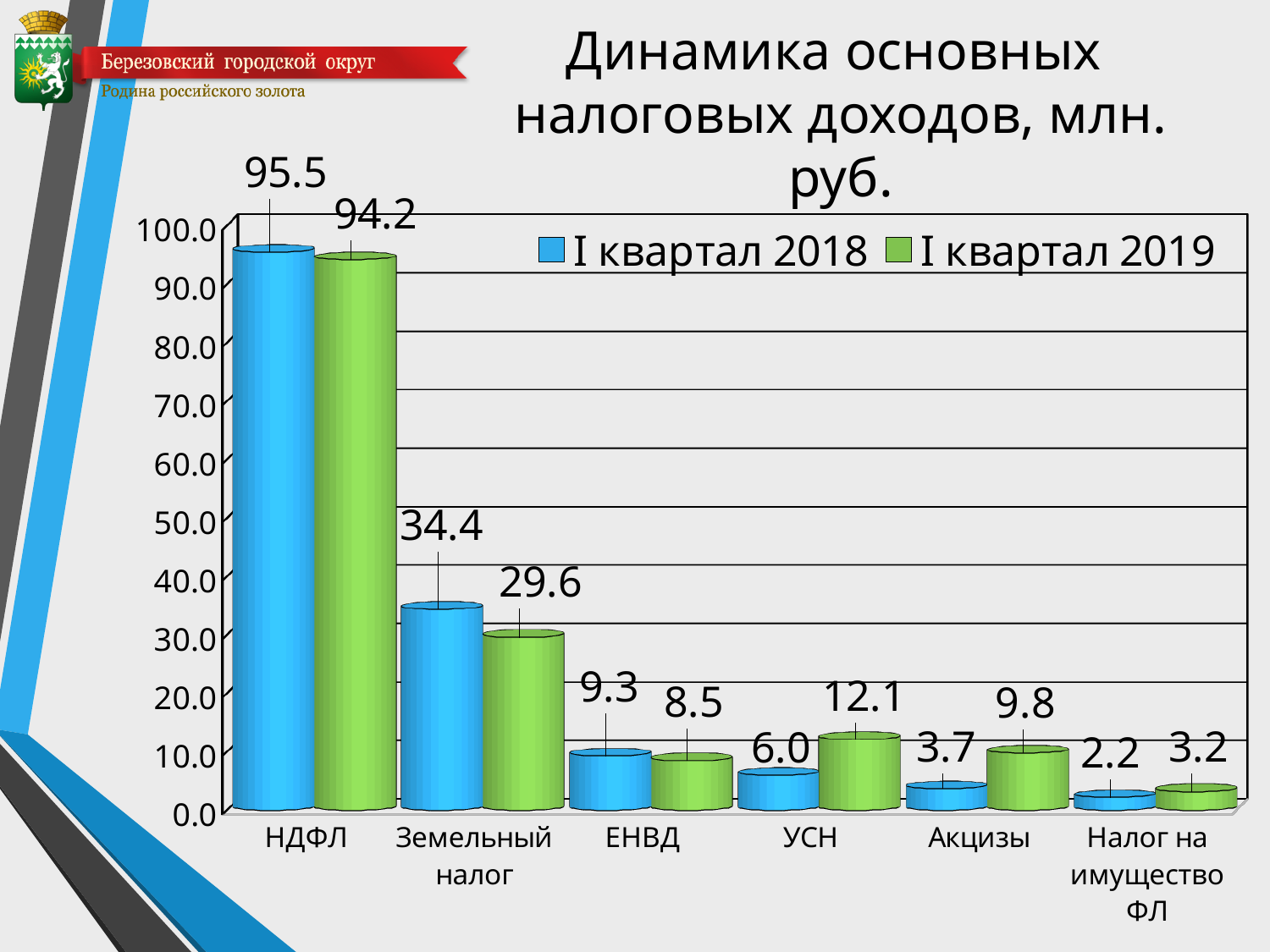
What is the value for НДФЛ in the I квартал 2018 series? 95.5 What kind of chart is shown on the slide? Bar chart Which category has the lowest value in the I квартал 2018 series? Налог на имущество ФЛ For УСН, which series has the larger value: I квартал 2018 or I квартал 2019? I квартал 2019 What is the difference between the I квартал 2018 and I квартал 2019 values for Земельный налог? 4.8 What is the title of the chart? Динамика основных налоговых доходов, млн. руб. How many series does the legend list? 2 Which category has the highest value in the I квартал 2019 series? НДФЛ How many categories are shown on the x axis? 6 What is the value for УСН in the I квартал 2019 series? 12.1 What is the value for Акцизы in the I квартал 2018 series? 3.7 Is the I квартал 2019 value for Земельный налог greater or less than 20.0? greater